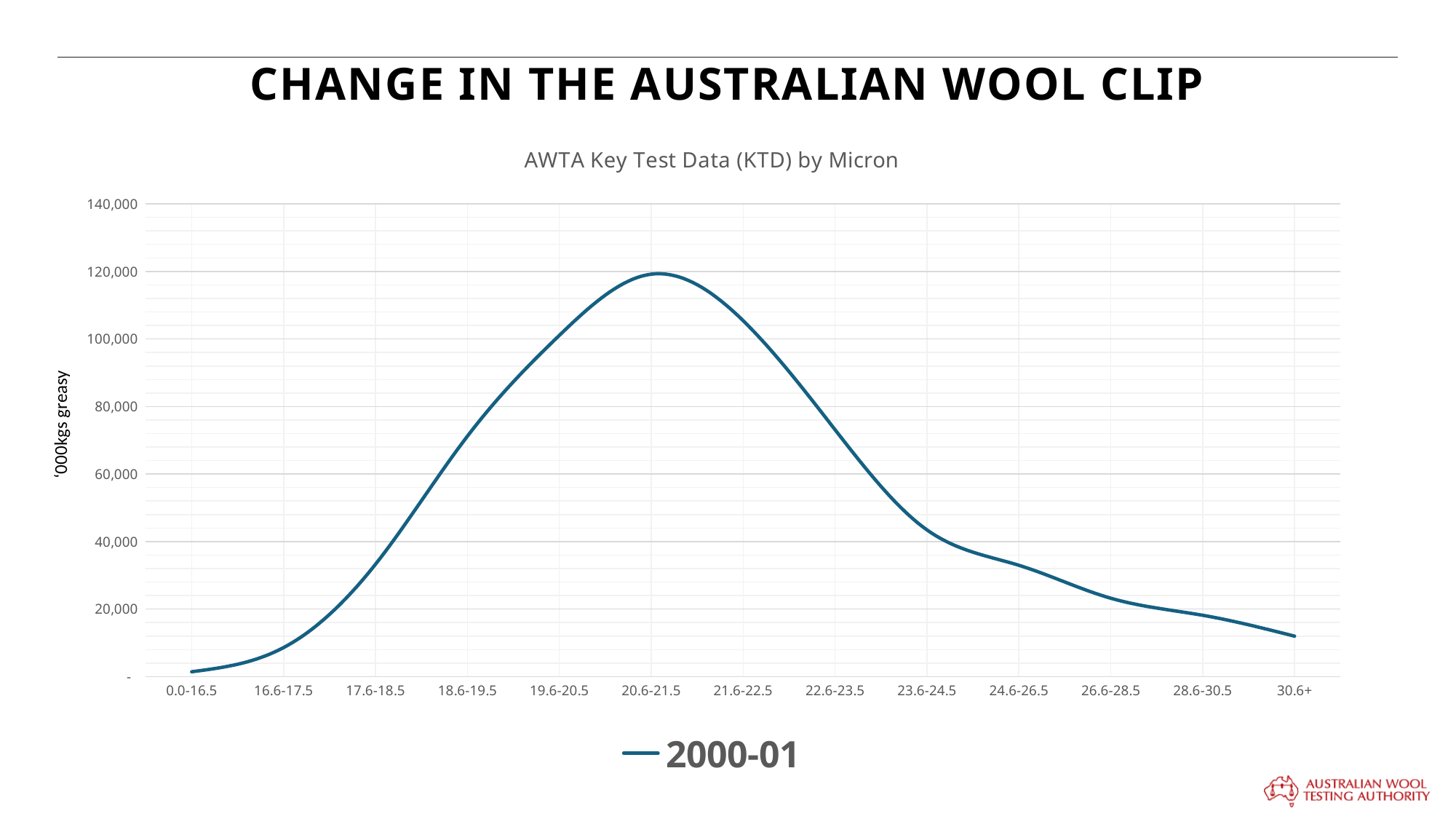
How many micron categories are shown on the x axis? 13 What kind of chart is shown on the slide? Line chart Is the value for 20.6-21.5 greater or less than 100,000? greater Which micron category has the highest value for 2000-01? 20.6-21.5 Is the value for 24.6-26.5 greater or less than 40,000? less What is the label on the y axis? '000kgs greasy Which has the larger value, 19.6-20.5 or 23.6-24.5? 19.6-20.5 How many series does the legend list? 1 Is the value for 22.6-23.5 greater or less than 60,000? greater Which micron category has the lowest value for 2000-01? 0.0-16.5 Do the values rise or fall along the x axis from 20.6-21.5 to 30.6+? fall